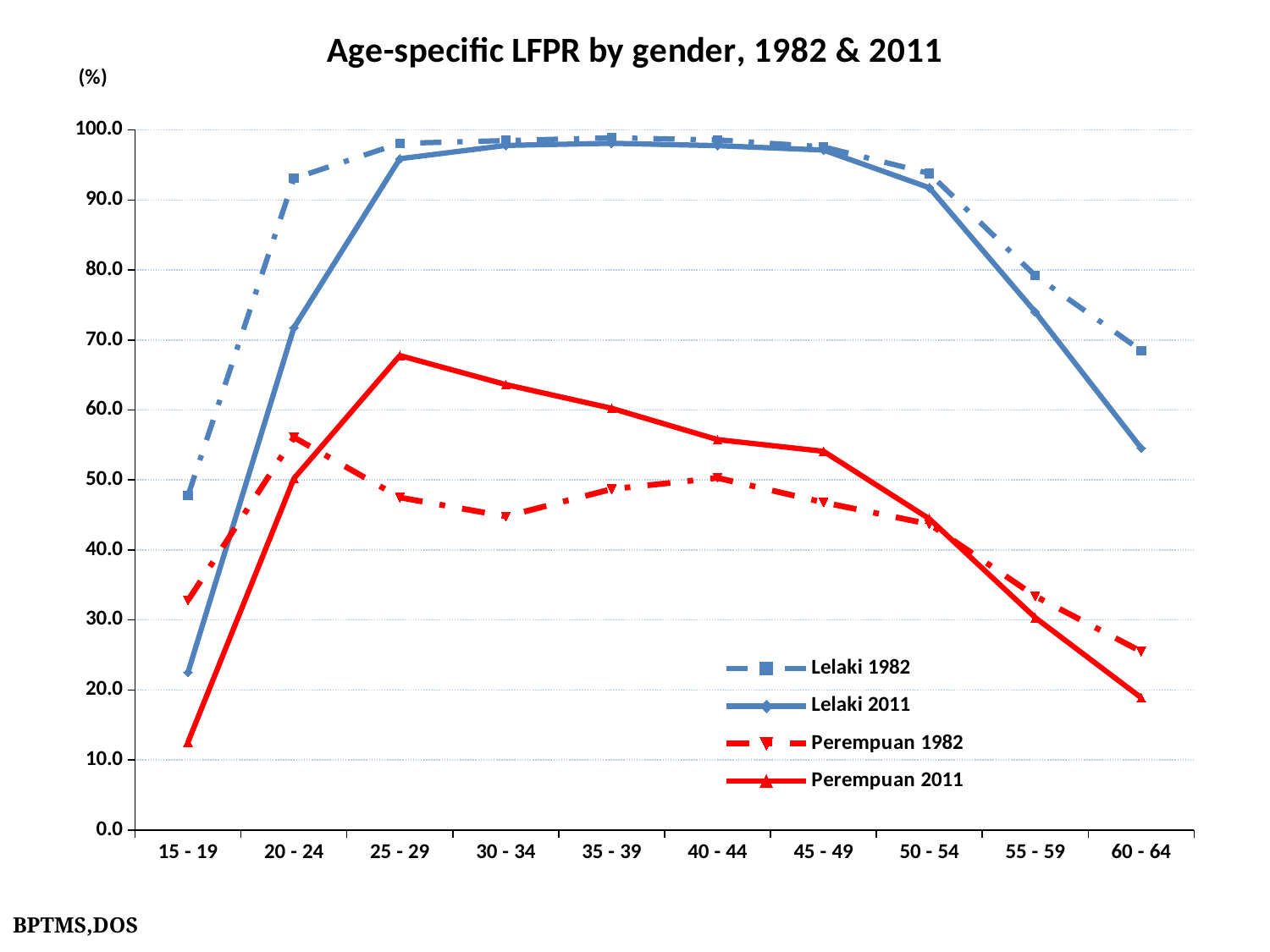
How many age groups are shown on the x axis? 10 How many series does the legend list? 4 Is the value for Lelaki 1982 in the 60 - 64 age group greater or less than 60.0? greater What kind of chart is shown on the slide? line chart In the 20 - 24 age group, which is larger: Lelaki 1982 or Lelaki 2011? Lelaki 1982 In the 15 - 19 age group, which is larger: Perempuan 1982 or Perempuan 2011? Perempuan 1982 Does the Perempuan 2011 series rise or fall from the 25 - 29 age group to the 60 - 64 age group? fall Is the value for Lelaki 2011 in the 60 - 64 age group greater or less than 50.0? greater In which age group does the Lelaki 2011 series have its lowest value? 15 - 19 What is the title of the chart? Age-specific LFPR by gender, 1982 & 2011 Is the value for Perempuan 2011 in the 15 - 19 age group greater or less than 20.0? less In which age group does the Perempuan 2011 series reach its highest value? 25 - 29